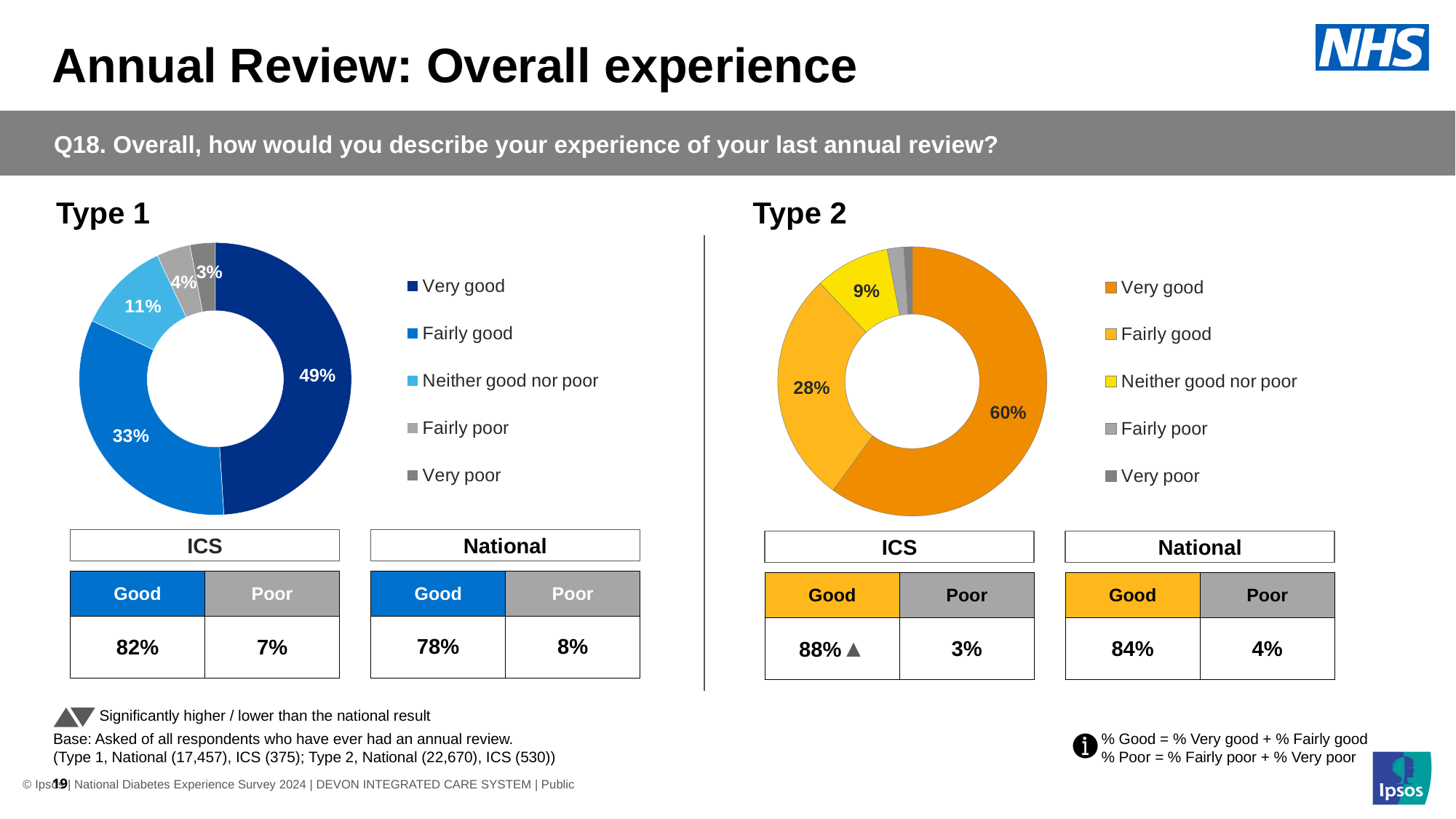
In the Type 1 chart, which response category has the largest share? Very good What kind of chart is used to show the Type 1 results? Donut (pie) chart How many response categories does the legend of the Type 2 chart list? 5 In the Type 1 chart, what is the difference between the Very good and Fairly good shares? 16 percentage points Which chart has the larger Very good share, Type 1 or Type 2? Type 2 In the Type 2 chart, what percentage of respondents said their experience was Fairly good? 28% In the Type 1 chart, what percentage of respondents said their experience was Fairly good? 33% In the Type 2 chart, what percentage of respondents said Neither good nor poor? 9% In the Type 1 chart, which response category has the smallest share? Very poor In the Type 2 chart, what percentage of respondents said their experience was Very good? 60% In the Type 1 chart, what percentage of respondents said their experience was Very good? 49% In the Type 1 chart, what percentage of respondents said Neither good nor poor? 11%